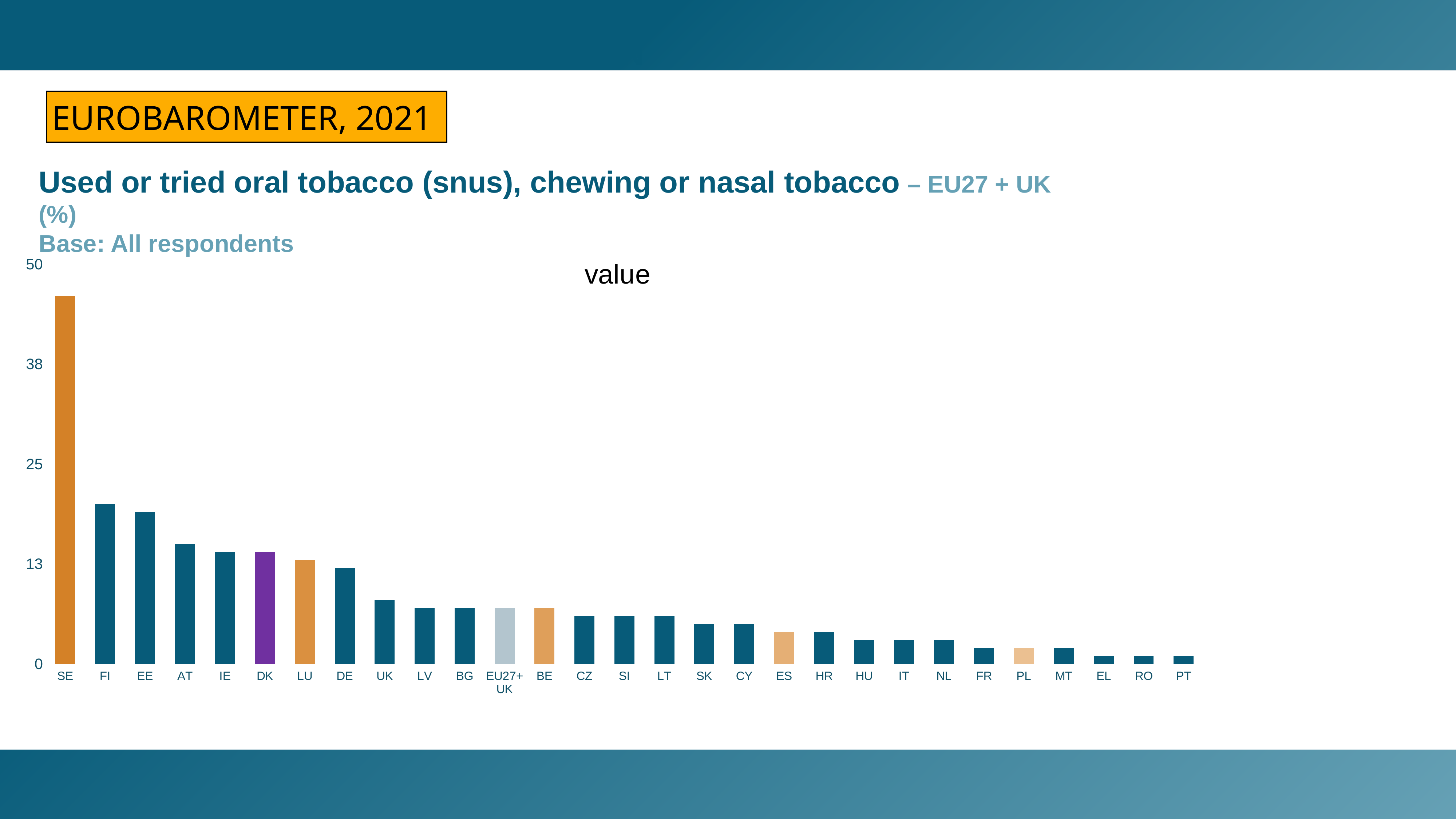
Which country has the highest value in the chart? SE Which is larger, the value for SE or the value for FI? SE How many categories are shown along the x axis of the chart? 29 Which is larger, the value for HR or the value for FR? HR Is the value for AT greater or less than 13? greater Do the bar values rise or fall moving from left to right along the x axis? fall What is the title printed above the plot area of the chart? value Is the value for UK greater or less than 13? less Is the value for FI greater or less than 25? less Which is larger, the value for AT or the value for DE? AT What kind of chart is shown on the slide? bar chart